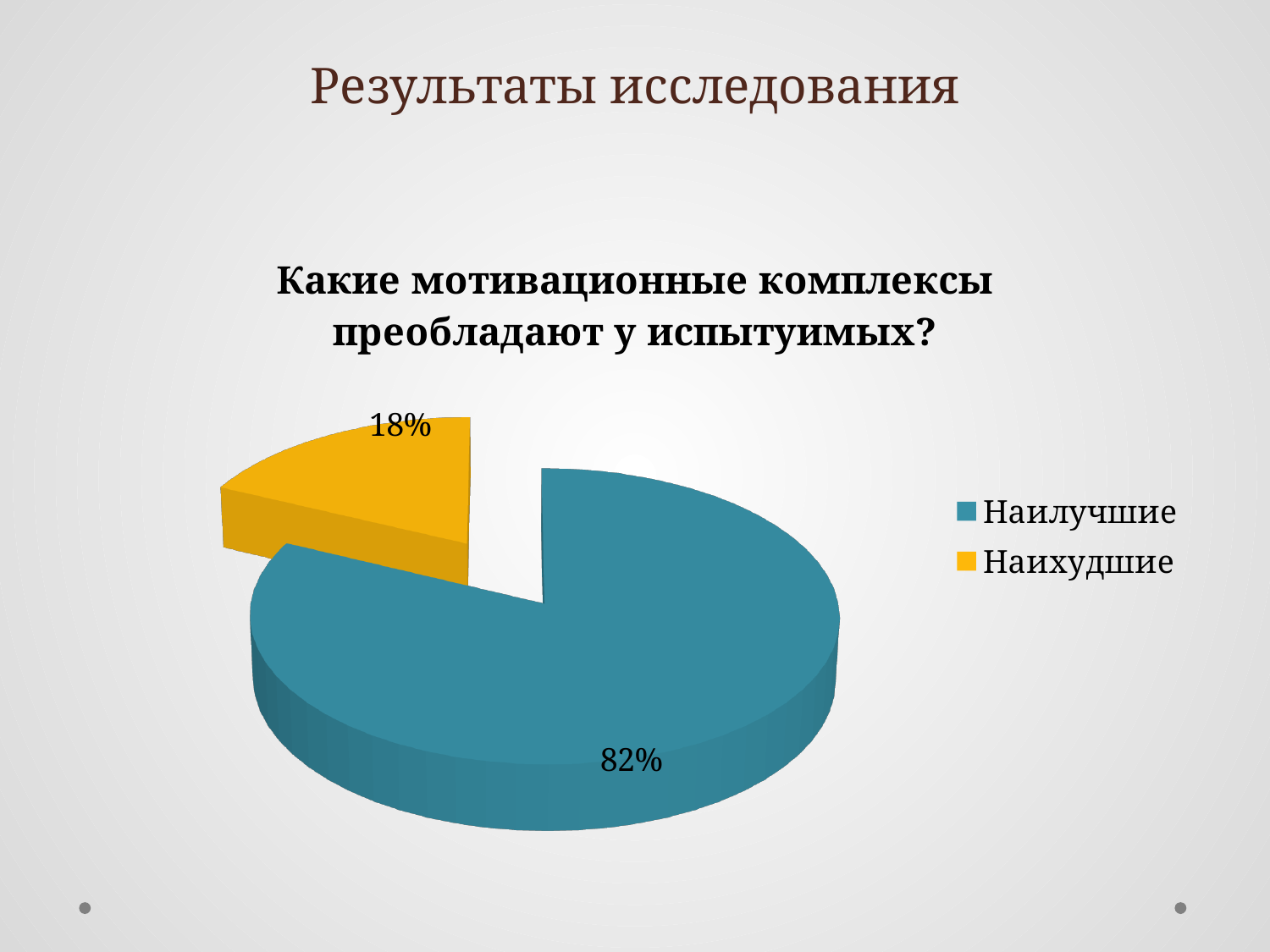
What is the title of the chart? Какие мотивационные комплексы преобладают у испытуимых? What share of the pie does the "Наилучшие" slice represent? 82% What kind of chart is shown on the slide? pie chart How many entries does the legend list? 2 What is the difference in percentage points between the "Наилучшие" and "Наихудшие" slices? 64 Which category has the largest slice of the pie? Наилучшие Which slice is larger, "Наилучшие" or "Наихудшие"? Наилучшие Which category has the smallest slice of the pie? Наихудшие How many slices does the pie chart have? 2 What share of the pie does the "Наихудшие" slice represent? 18% What colour is the "Наихудшие" slice? yellow